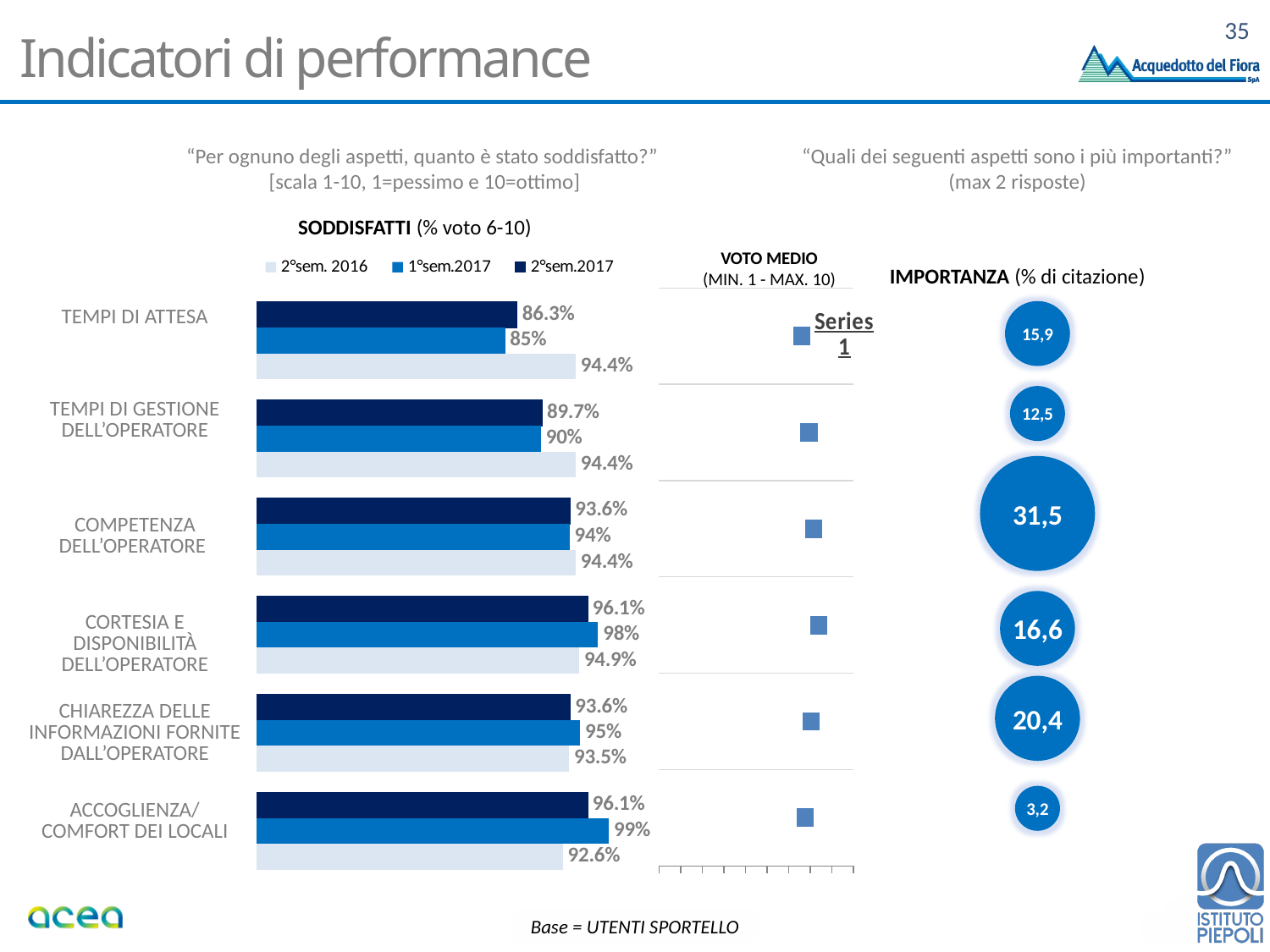
In the SODDISFATTI chart, what is the value for ACCOGLIENZA/COMFORT DEI LOCALI in 1°sem.2017? 99% What kind of chart is the SODDISFATTI chart? Bar chart In the SODDISFATTI chart, which is larger for COMPETENZA DELL'OPERATORE: the 1°sem.2017 value or the 2°sem.2017 value? 1°sem.2017 In the IMPORTANZA (% di citazione) chart, which aspect has the lowest value? ACCOGLIENZA/COMFORT DEI LOCALI In the SODDISFATTI chart, which category has the highest value for 2°sem. 2016? CORTESIA E DISPONIBILITÀ DELL'OPERATORE In the SODDISFATTI chart, what is the difference between the 2°sem. 2016 and 2°sem.2017 values for TEMPI DI ATTESA? 8.1% In the SODDISFATTI chart, what is the value for CORTESIA E DISPONIBILITÀ DELL'OPERATORE in 2°sem. 2016? 94.9% In the IMPORTANZA (% di citazione) chart, what is the value for COMPETENZA DELL'OPERATORE? 31,5 In the SODDISFATTI chart, which category has the lowest value for 1°sem.2017? TEMPI DI ATTESA In the SODDISFATTI chart, what is the value for TEMPI DI ATTESA in 2°sem.2017? 86.3% How many series does the legend of the SODDISFATTI chart list? 3 How many categories are shown in the SODDISFATTI chart? 6